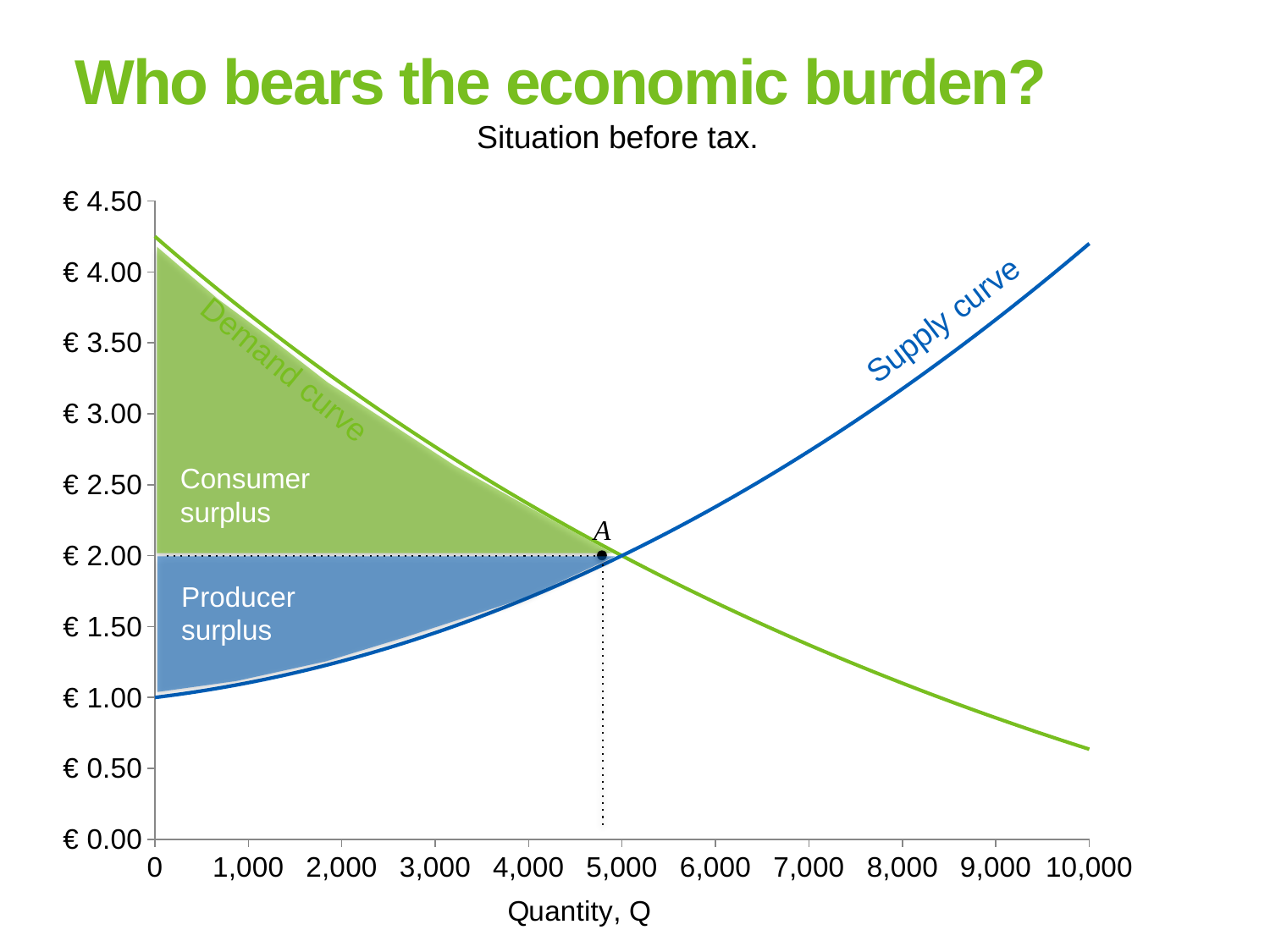
Is the price on the demand curve at a quantity of 0 greater or less than € 4.00? greater How many curves are plotted on the chart? 2 What kind of chart is shown on the slide? Line chart What is the label of the x axis? Quantity, Q Does the supply curve rise or fall as quantity increases? Rise What is the price on the supply curve at a quantity of 0? € 1.00 What is the subtitle shown above the chart? Situation before tax. Is the price on the demand curve at a quantity of 10,000 greater or less than € 1.00? less Is the quantity at point A greater or less than 4,000? greater At a quantity of 2,000, which curve shows the higher price, the demand curve or the supply curve? Demand curve Does the demand curve rise or fall as quantity increases? Fall What is the price at point A? € 2.00